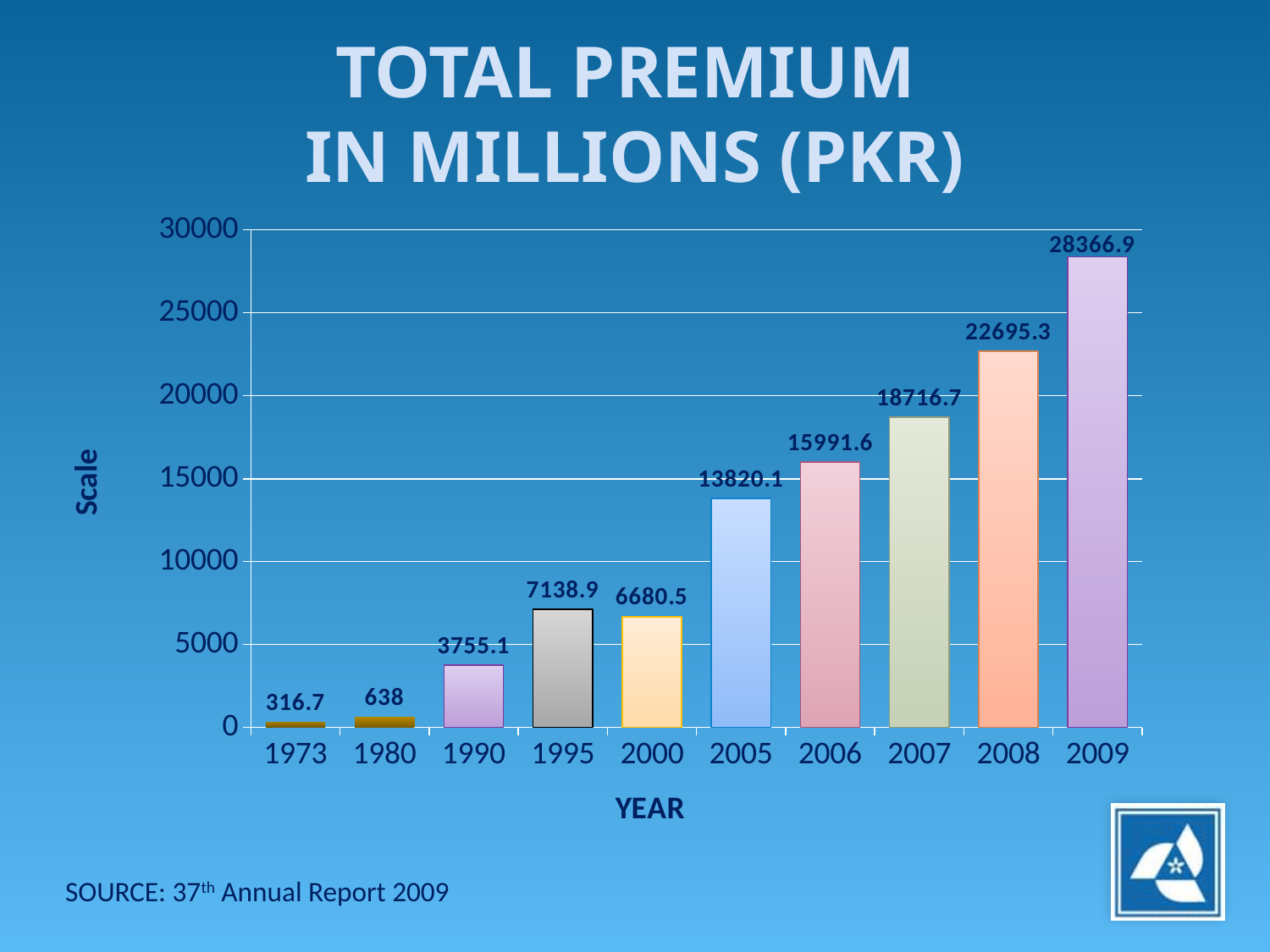
What is the total premium for 2000? 6680.5 Which year has the lowest total premium? 1973 What is the total premium for 2009? 28366.9 What is the difference between the total premium in 1995 and in 2000? 458.4 How many years are shown on the x axis? 10 What is the label of the x axis? YEAR Is the value for 2007 greater or less than 20000? less What is the total premium for 1973? 316.7 What is the difference between the total premium in 2009 and in 2008? 5671.6 Which year has the highest total premium? 2009 What kind of chart is shown on the slide? bar chart Which year has a larger total premium, 1995 or 2000? 1995